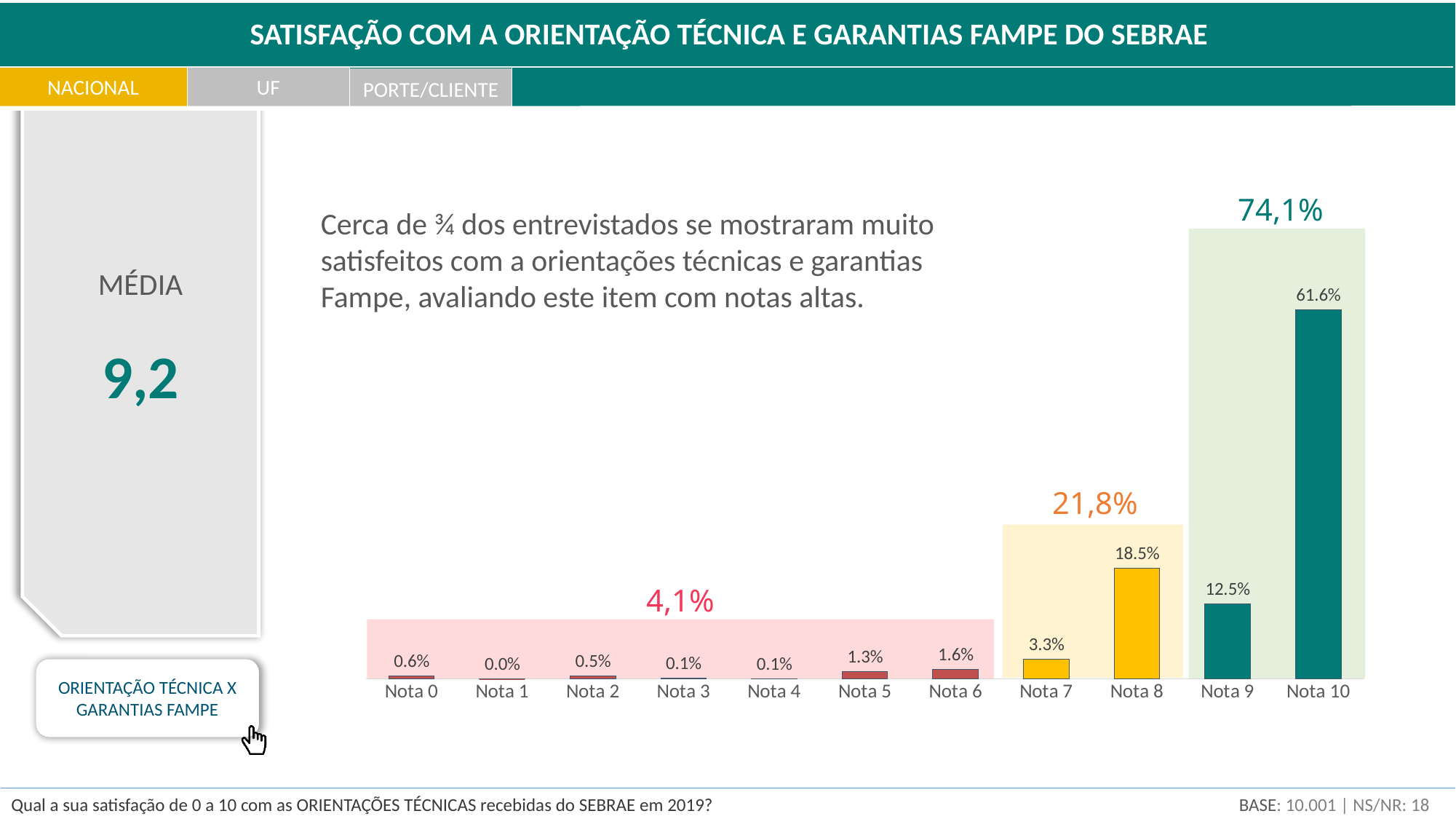
What is the value for Nota 8? 18.5% What kind of chart is shown on the slide? Bar chart What is the value for Nota 6? 1.6% What is the value for Nota 9? 12.5% What is the combined share shown for the group Nota 9 and Nota 10 (the green highlighted group)? 74,1% Which is larger, the value for Nota 9 or the value for Nota 8? Nota 8 What is the value for Nota 10? 61.6% Which category has the highest value? Nota 10 Which category has the lowest value? Nota 1 How many categories are shown on the x axis? 11 What is the value for Nota 7? 3.3% What is the difference between the values for Nota 10 and Nota 8? 43.1%